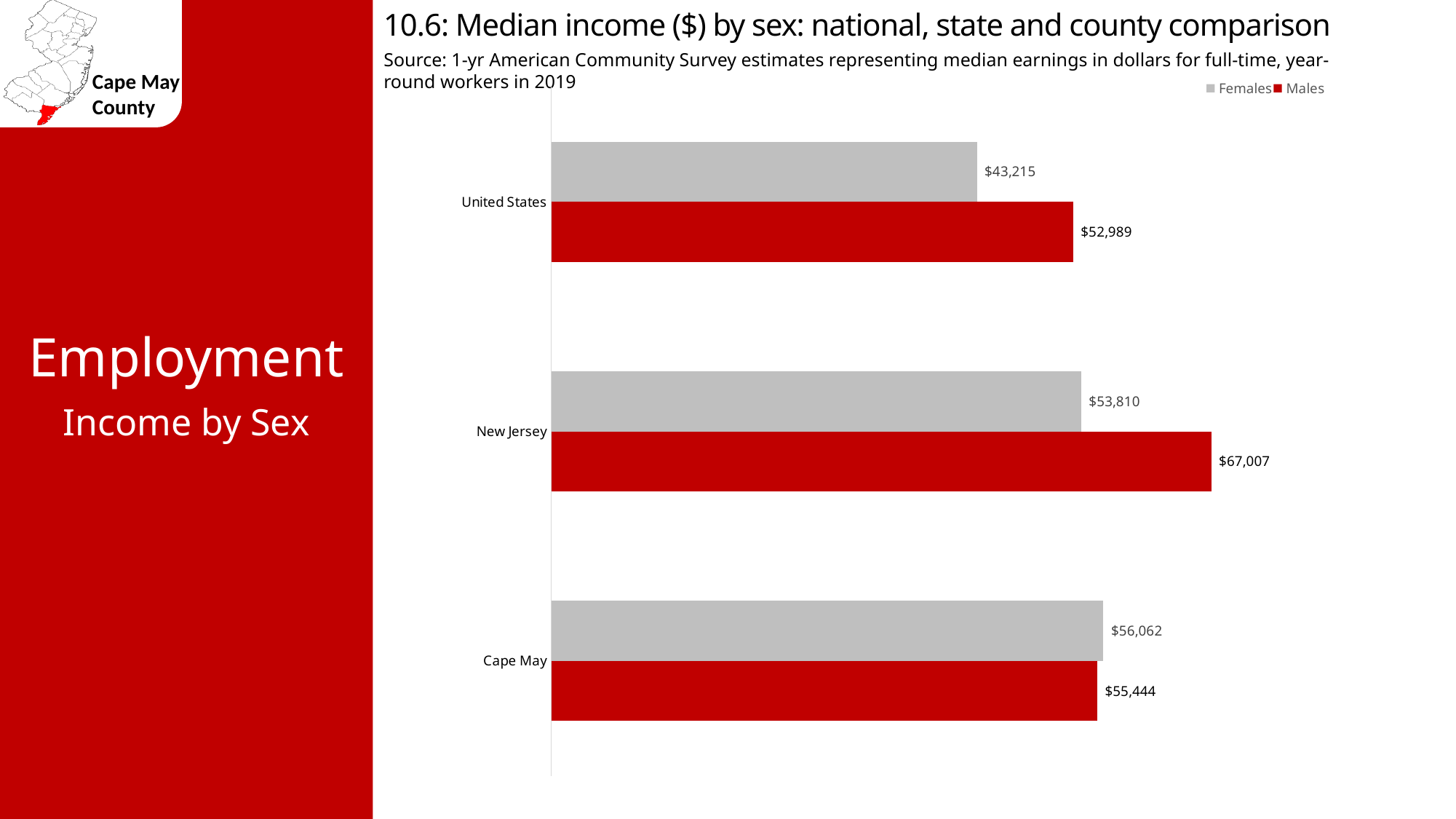
What is the median income for females in the United States? $43,215 Which area has the lowest median income for females? United States What is the difference between male and female median income in the United States? $9,774 What is the difference between male and female median income in New Jersey? $13,197 What type of chart is shown on the slide? Bar chart Which area has the highest median income for females? Cape May How many areas are compared in the chart? 3 Which area has the highest median income for males? New Jersey In New Jersey, is the median income higher for males or females? Males What is the median income for males in Cape May? $55,444 What is the median income for males in New Jersey? $67,007 What is the median income for females in Cape May? $56,062